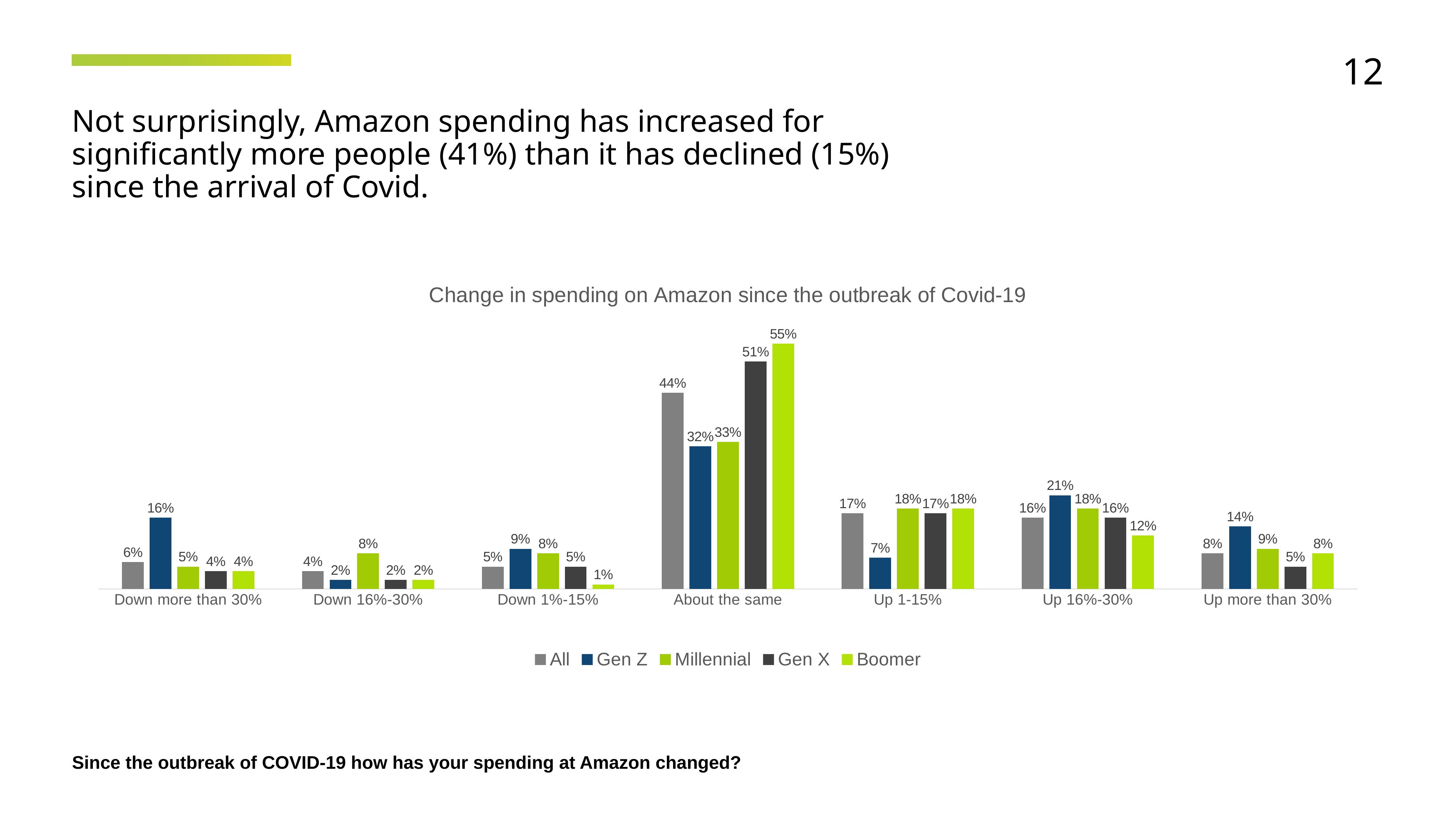
Which is larger in the 'Up more than 30%' category: Gen Z or Gen X? Gen Z Which series has the lowest value in the 'Down 1%-15%' category? Boomer What is the value for Gen Z in the 'Down more than 30%' category? 16% What is the difference between the Boomer and Gen Z values in the 'About the same' category? 23% What is the difference between the Gen Z and Gen X values in the 'Down more than 30%' category? 12% What is the value for Boomer in the 'About the same' category? 55% What is the value for All in the 'Up 16%-30%' category? 16% How many series does the legend list? 5 What kind of chart is shown on the slide? Bar chart What is the title of the chart? Change in spending on Amazon since the outbreak of Covid-19 Which series has the highest value in the 'About the same' category? Boomer How many categories are shown on the x axis? 7